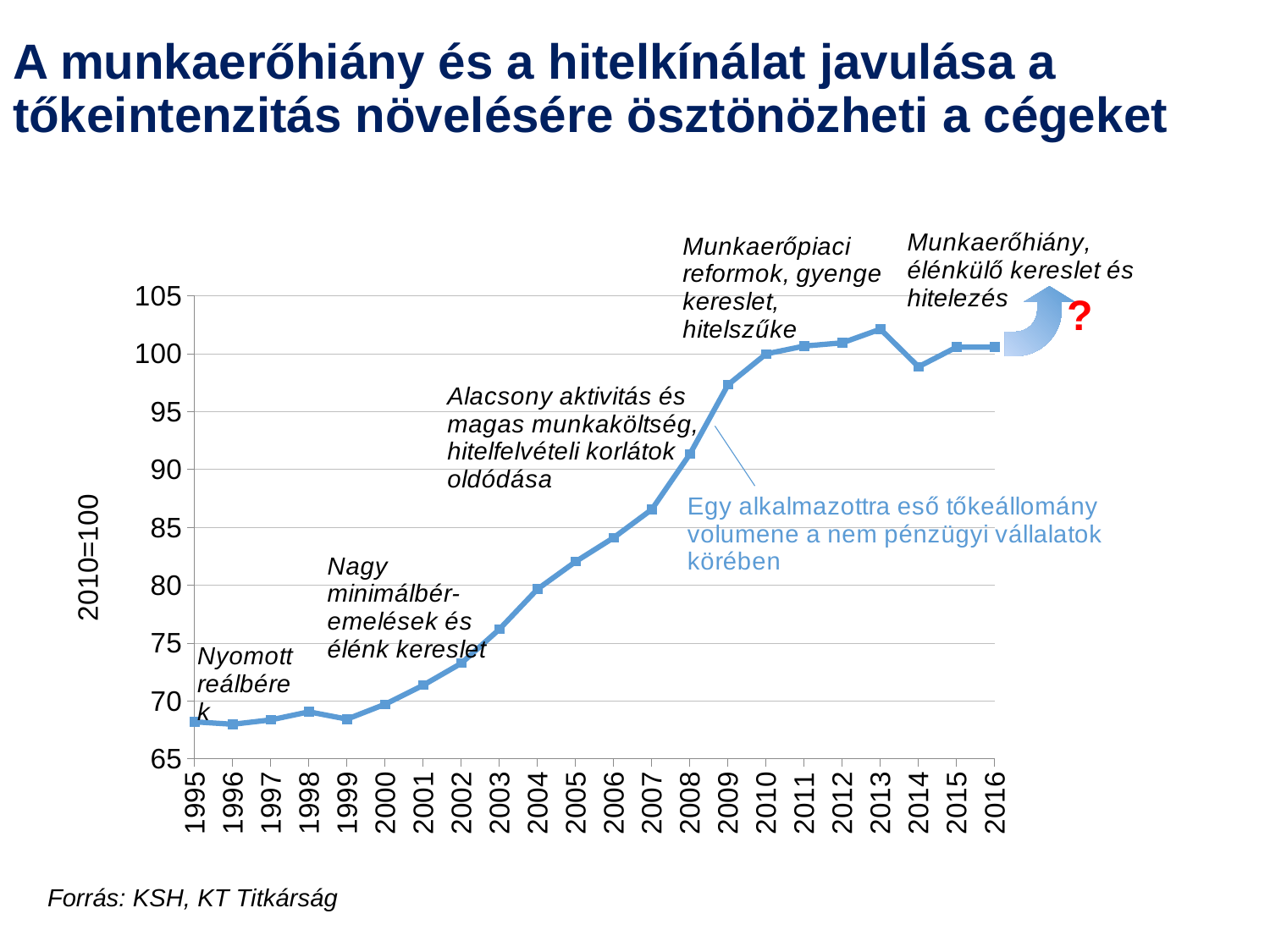
Which year has the larger value, 2013 or 2014? 2013 Is the value for 2008 greater or less than 90? greater What source is cited below the chart? KSH, KT Titkárság What is the value of the index for 2010? 100 Is the value for 1995 greater or less than 70? less How many yearly data points are plotted on the chart? 22 What is the label on the vertical axis of the chart? 2010=100 Is the value for 2005 greater or less than 80? greater Which year has the highest value on the chart? 2013 What kind of chart is shown on the slide? line chart Does the series generally rise or fall from 1995 to 2016? rise